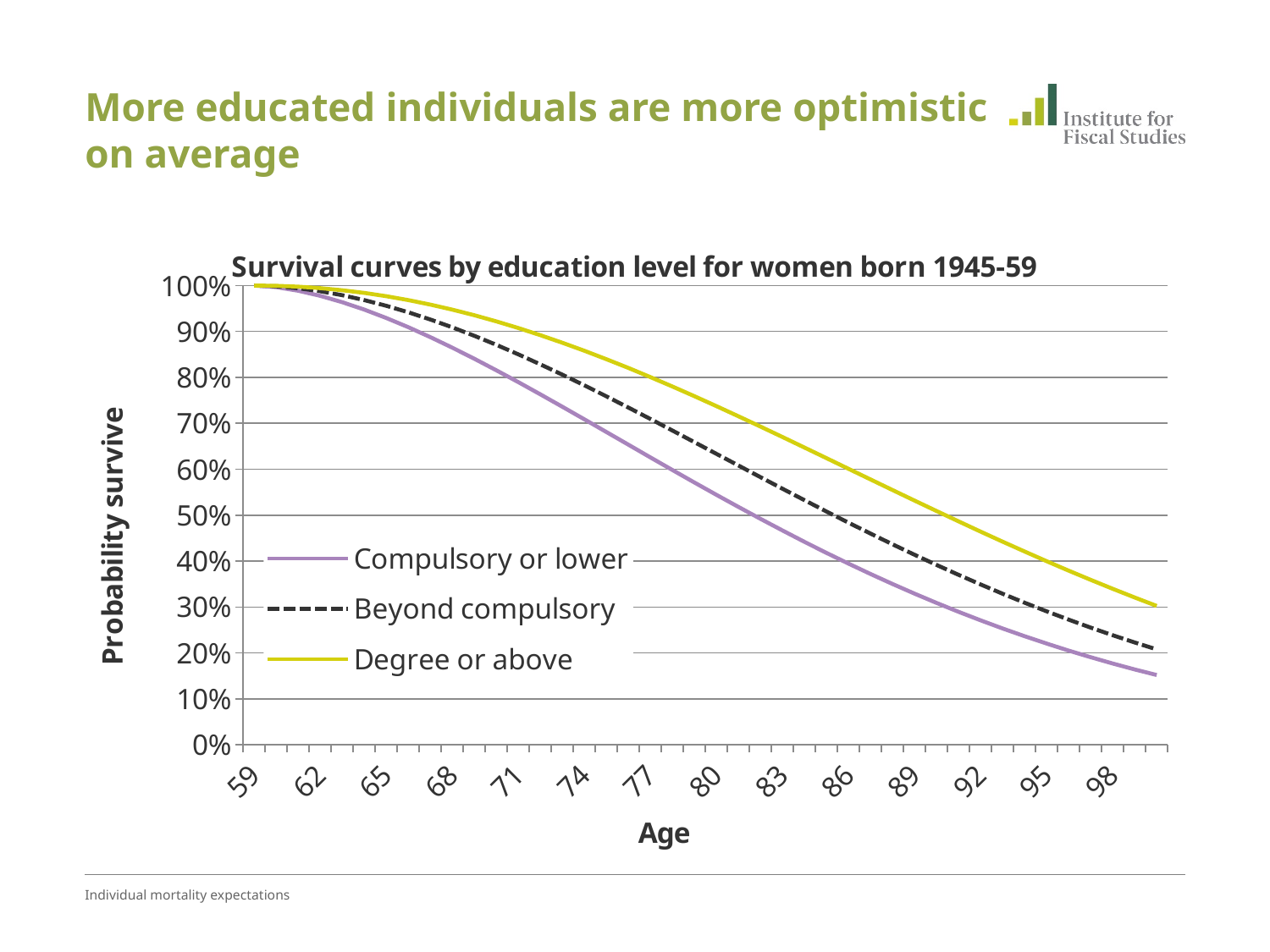
Is the probability of survival at age 98 for Degree or above greater or less than 30%? greater At age 86, is the probability of survival higher for Beyond compulsory or for Compulsory or lower? Beyond compulsory What kind of chart is shown on the slide? line chart What is the title of the chart? Survival curves by education level for women born 1945-59 Which education level has the lowest probability of survival at age 80? Compulsory or lower How many series does the legend list? 3 Is the probability of survival at age 98 for Compulsory or lower greater or less than 20%? less Is the probability of survival at age 80 for Degree or above greater or less than 70%? greater Which education level has the highest probability of survival at age 89? Degree or above What is the probability of survival at age 59 for the Degree or above series? 100% Do the survival curves rise or fall as age increases? fall What is the label of the vertical axis? Probability survive